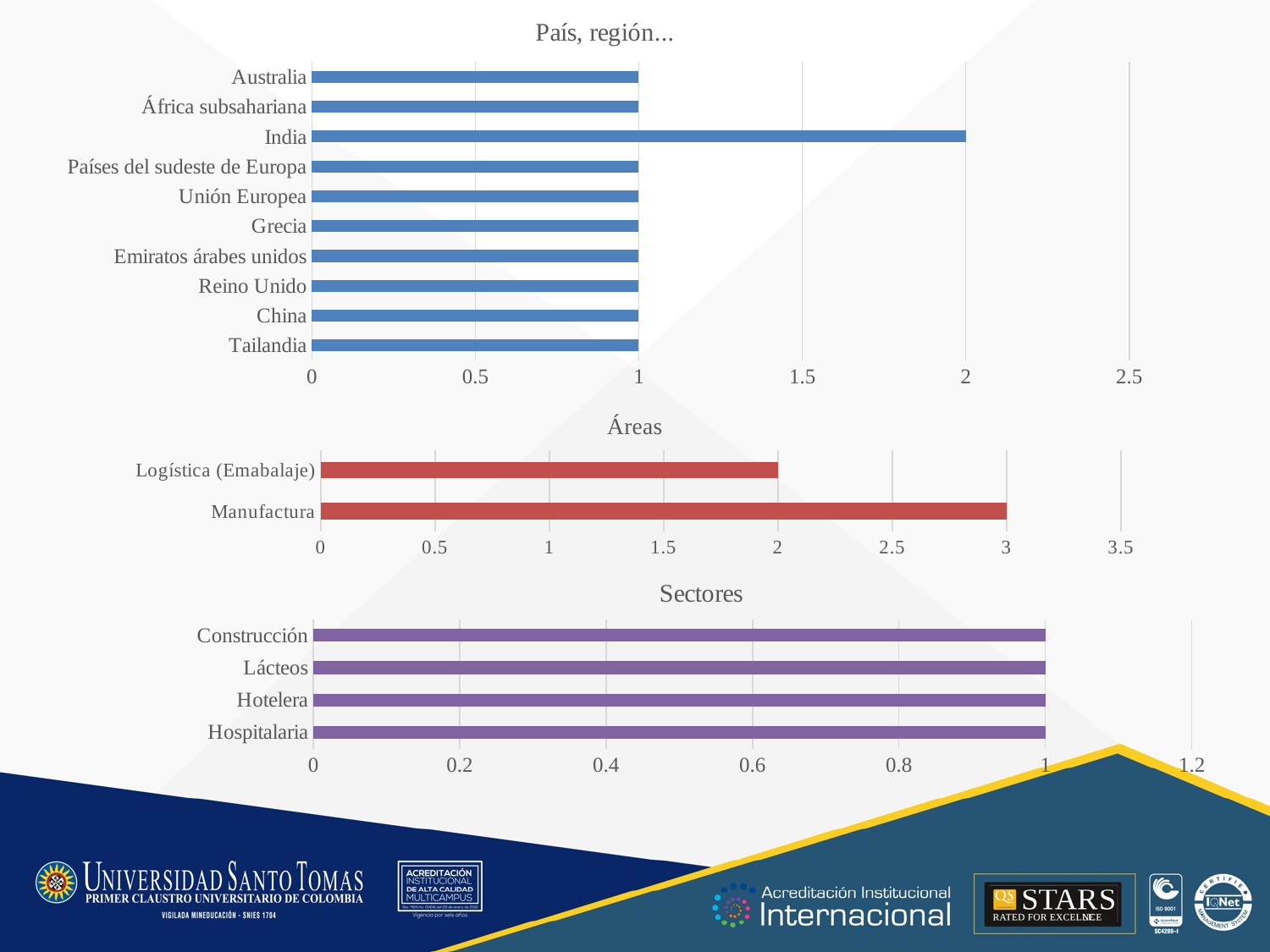
In the 'Áreas' chart, what is the value for Logística (Emabalaje)? 2 In the 'Sectores' chart, what is the value for Hotelera? 1 In the 'Áreas' chart, which category has the highest value? Manufactura In the 'País, región...' chart, which category has the highest value? India In the 'País, región...' chart, how many categories are plotted? 10 In the 'Áreas' chart, what is the value for Manufactura? 3 In the 'País, región...' chart, what is the difference between the values for India and Australia? 1 In the 'Áreas' chart, is the value for Manufactura greater or less than 2.5? greater In the 'País, región...' chart, what is the value for India? 2 In the 'País, región...' chart, what is the value for China? 1 What kind of chart is the 'Sectores' chart? Bar chart In the 'Sectores' chart, how many categories are plotted? 4